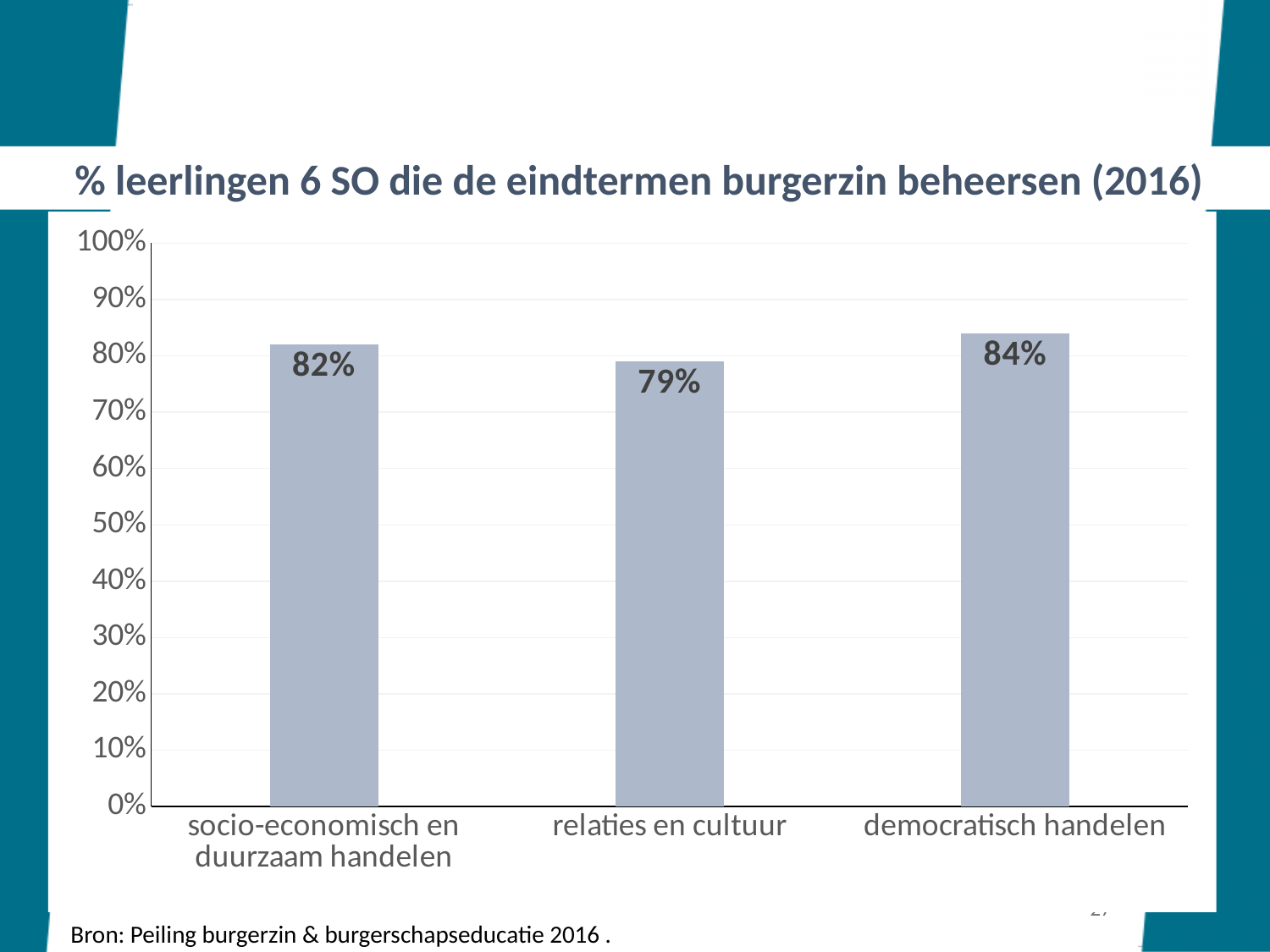
What is the value for 'relaties en cultuur'? 79% Which category has the lowest value? relaties en cultuur What is the difference between the values for 'democratisch handelen' and 'relaties en cultuur'? 5% What kind of chart is shown on the slide? bar chart Which is larger: the value for 'socio-economisch en duurzaam handelen' or for 'democratisch handelen'? democratisch handelen What is the title of the chart? % leerlingen 6 SO die de eindtermen burgerzin beheersen (2016) How many categories are shown on the chart? 3 What is the value for 'democratisch handelen'? 84% What is the value for 'socio-economisch en duurzaam handelen'? 82% Is the value for 'relaties en cultuur' greater or less than 80%? less What is the difference between the values for 'socio-economisch en duurzaam handelen' and 'relaties en cultuur'? 3% Which category has the highest value? democratisch handelen